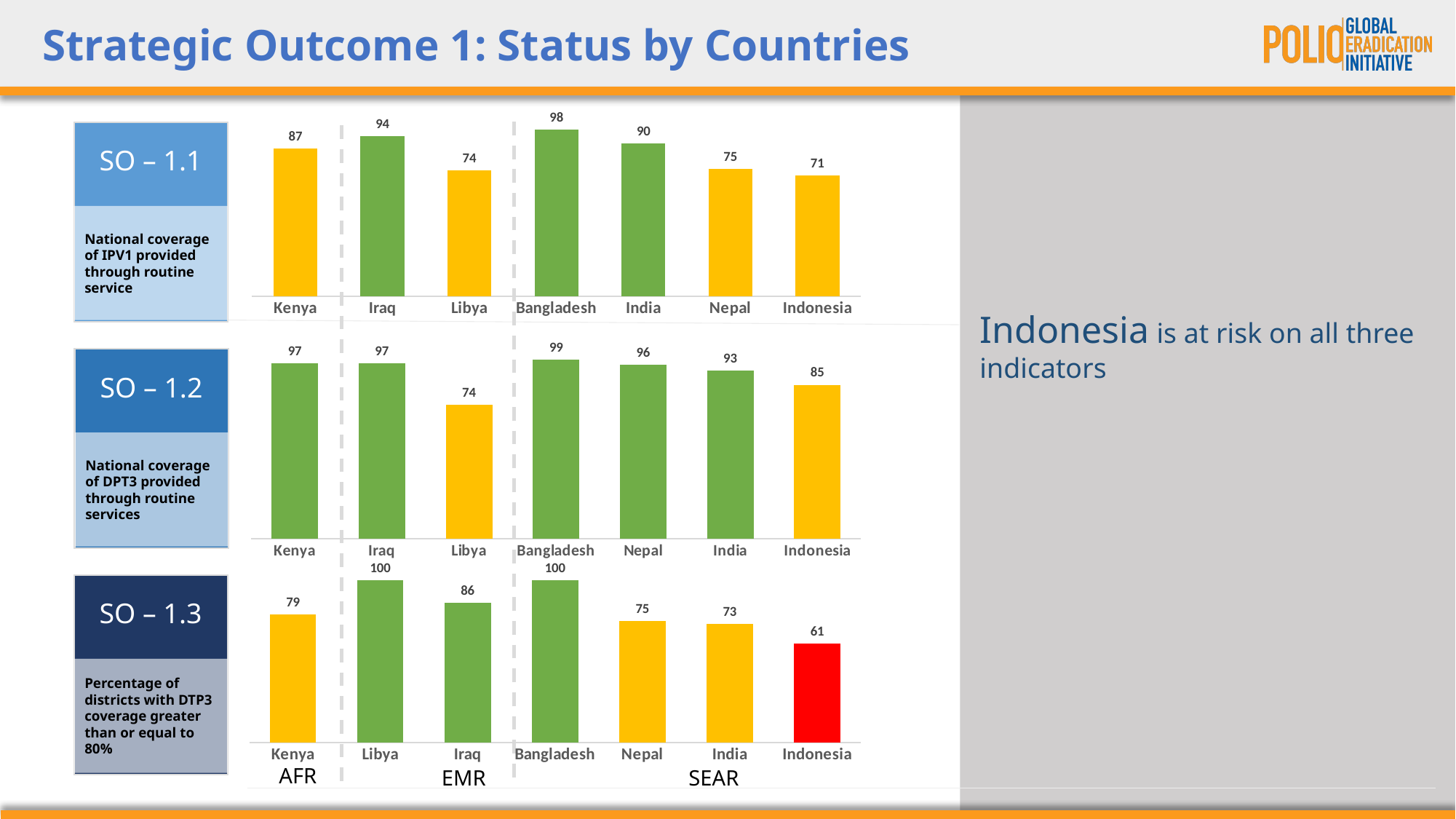
In the SO – 1.2 chart (middle), what is the value for Indonesia? 85 In the SO – 1.1 chart (top), what is the value for Bangladesh? 98 In the SO – 1.3 chart (bottom), which country's bar is coloured red? Indonesia How many countries are shown in the SO – 1.3 chart (bottom)? 7 In the SO – 1.3 chart (bottom), which is larger, the value for Kenya or the value for Iraq? Iraq In the SO – 1.2 chart (middle), which country has the lowest value? Libya In the SO – 1.1 chart (top), what is the difference between the values for Iraq and Libya? 20 In the SO – 1.1 chart (top), which country has the lowest value? Indonesia In the SO – 1.3 chart (bottom), what is the value for Indonesia? 61 In the SO – 1.3 chart (bottom), what is the difference between the values for Nepal and India? 2 What kind of chart is the SO – 1.1 chart (top)? Bar chart In the SO – 1.2 chart (middle), which country has the highest value? Bangladesh